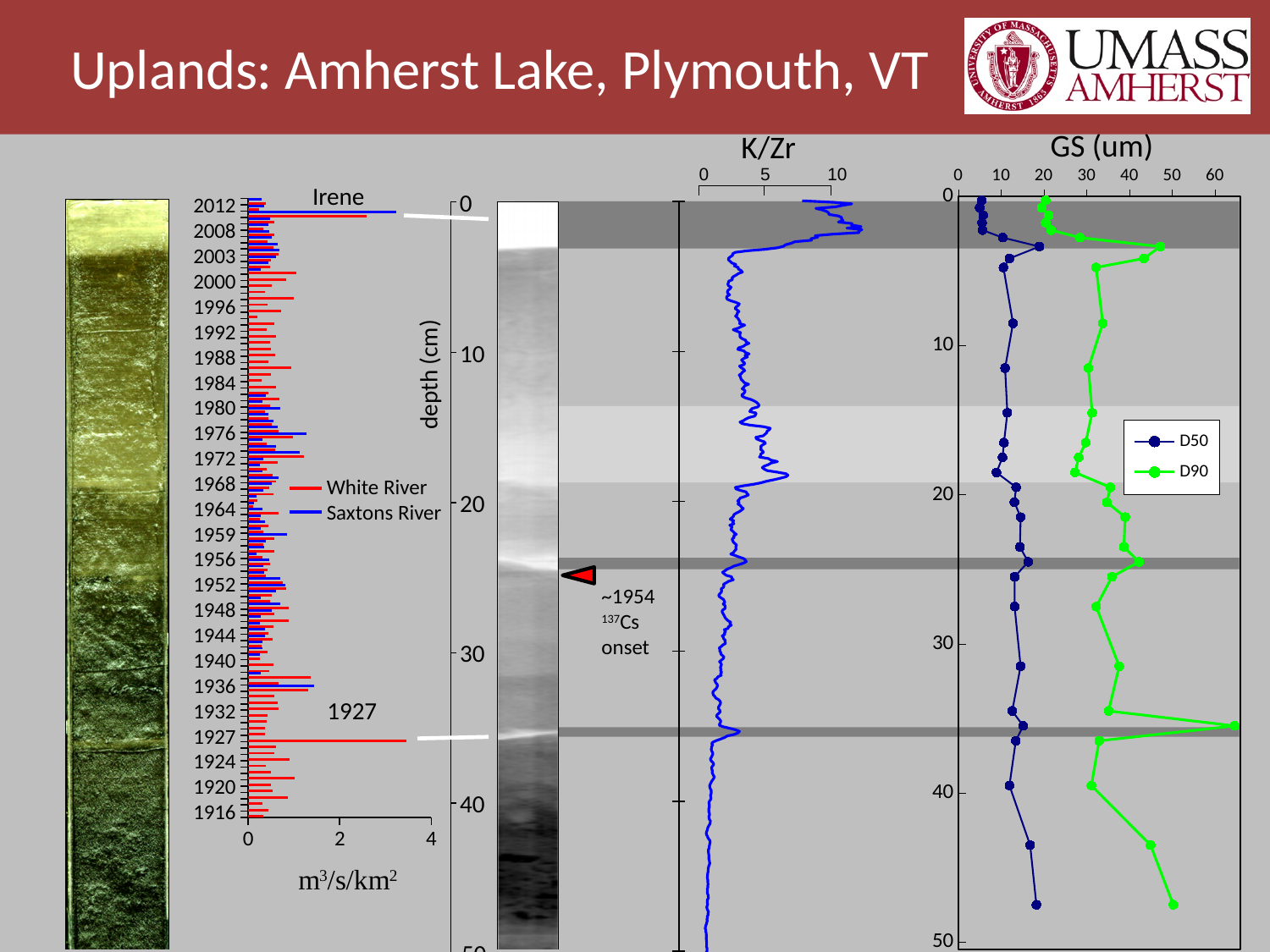
In the discharge bar chart on the left, which year has the largest White River bar? 1927 In the discharge bar chart on the left, how many series does the legend list? 2 What kind of chart is the discharge chart on the left (the one with years on the vertical axis)? bar chart In the discharge bar chart on the left, is the Saxtons River value for the Irene event greater or less than 2? greater In the K/Zr chart in the middle, is the value at 0 cm depth greater or less than 5? greater In the GS (um) chart on the right, which series has the larger values, D50 or D90? D90 In the discharge bar chart on the left, what are the two series named in the legend? White River and Saxtons River In the discharge bar chart on the left, is the White River value for 1927 greater or less than 2? greater In the discharge bar chart on the left, what unit is shown on the horizontal axis? m³/s/km² In the GS (um) chart on the right, how many series does the legend list? 2